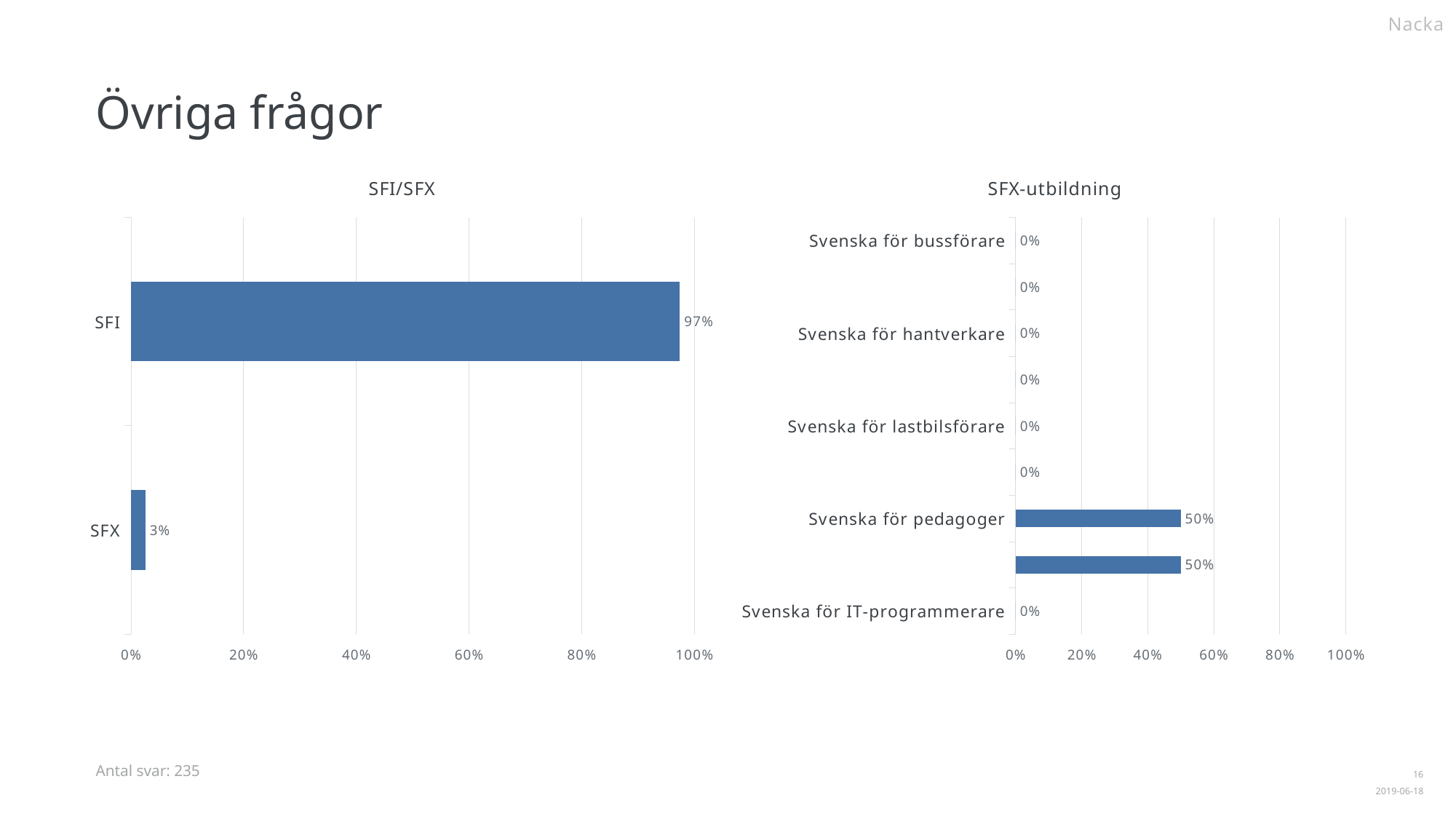
What is the title of the chart on the right side of the slide? SFX-utbildning In the SFI/SFX chart, how many categories are shown? 2 In the SFI/SFX chart, what is the value for SFX? 3% In the SFI/SFX chart, which category has the highest value? SFI What kind of chart is the SFI/SFX chart? Bar chart In the SFI/SFX chart, which category has the lowest value? SFX In the SFX-utbildning chart, what is the value for Svenska för IT-programmerare? 0% In the SFI/SFX chart, what is the value for SFI? 97% In the SFI/SFX chart, what is the difference between the values for SFI and SFX? 94% In the SFX-utbildning chart, which is larger, the value for Svenska för pedagoger or the value for Svenska för hantverkare? Svenska för pedagoger In the SFX-utbildning chart, what is the value for Svenska för pedagoger? 50% In the SFX-utbildning chart, what is the value for Svenska för bussförare? 0%